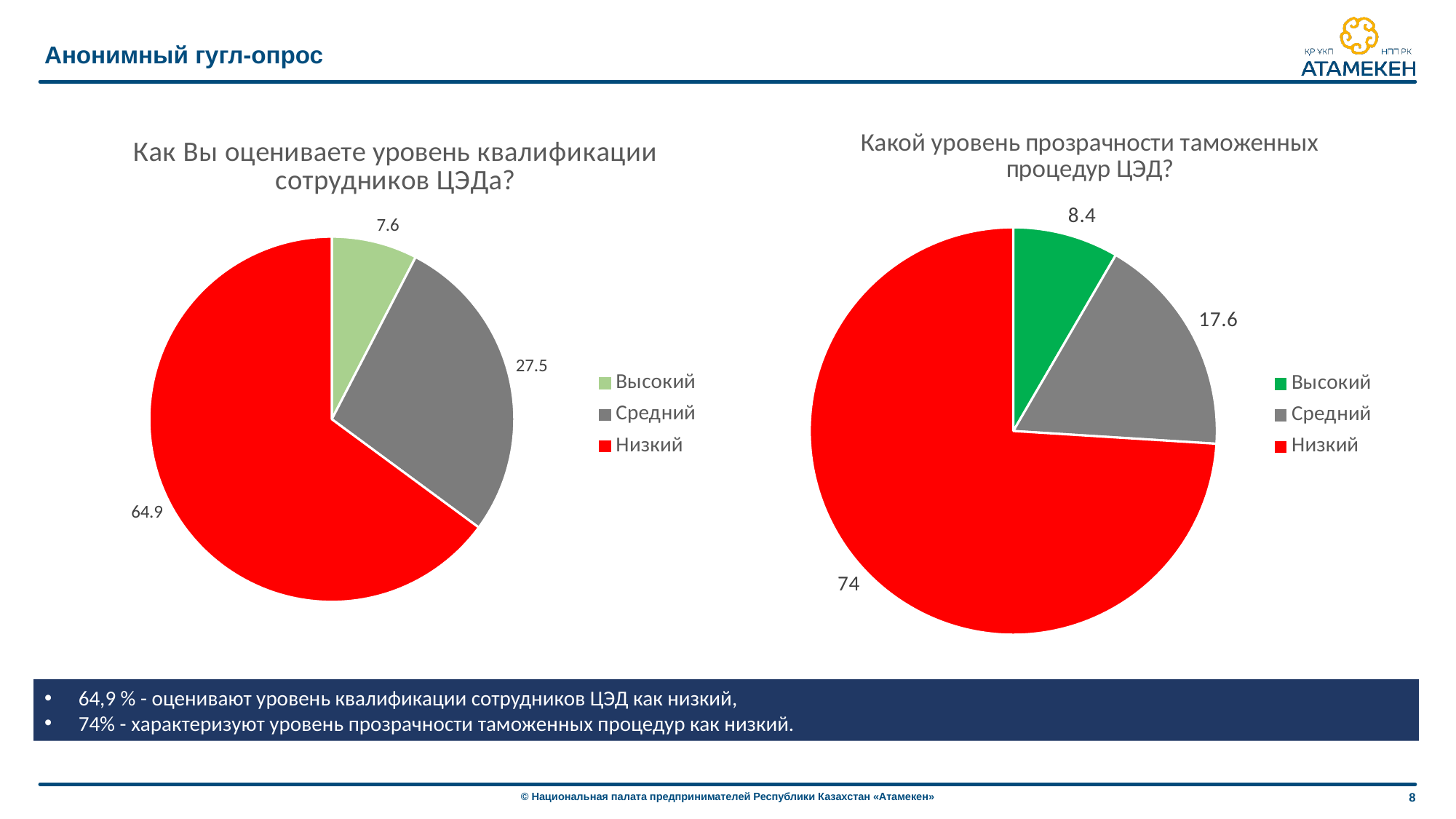
How many categories does the left chart (Как Вы оцениваете уровень квалификации сотрудников ЦЭДа?) show? 3 In the right chart (Какой уровень прозрачности таможенных процедур ЦЭД?), what is the value for Низкий? 74 In the right chart (Какой уровень прозрачности таможенных процедур ЦЭД?), which category has the smallest slice? Высокий In the left chart (Как Вы оцениваете уровень квалификации сотрудников ЦЭДа?), what is the value for Высокий? 7.6 Which is larger: the value for Высокий in the left chart or the value for Высокий in the right chart? The right chart (8.4) In the left chart (Как Вы оцениваете уровень квалификации сотрудников ЦЭДа?), what is the value for Низкий? 64.9 In the left chart (Как Вы оцениваете уровень квалификации сотрудников ЦЭДа?), which category has the largest slice? Низкий What type of chart is the right chart (Какой уровень прозрачности таможенных процедур ЦЭД?)? Pie chart In the right chart (Какой уровень прозрачности таможенных процедур ЦЭД?), what is the difference between the values for Низкий and Средний? 56.4 In the right chart (Какой уровень прозрачности таможенных процедур ЦЭД?), what is the value for Средний? 17.6 In the right chart (Какой уровень прозрачности таможенных процедур ЦЭД?), what colour is the Низкий slice? Red In the left chart (Как Вы оцениваете уровень квалификации сотрудников ЦЭДа?), what is the difference between the values for Средний and Высокий? 19.9